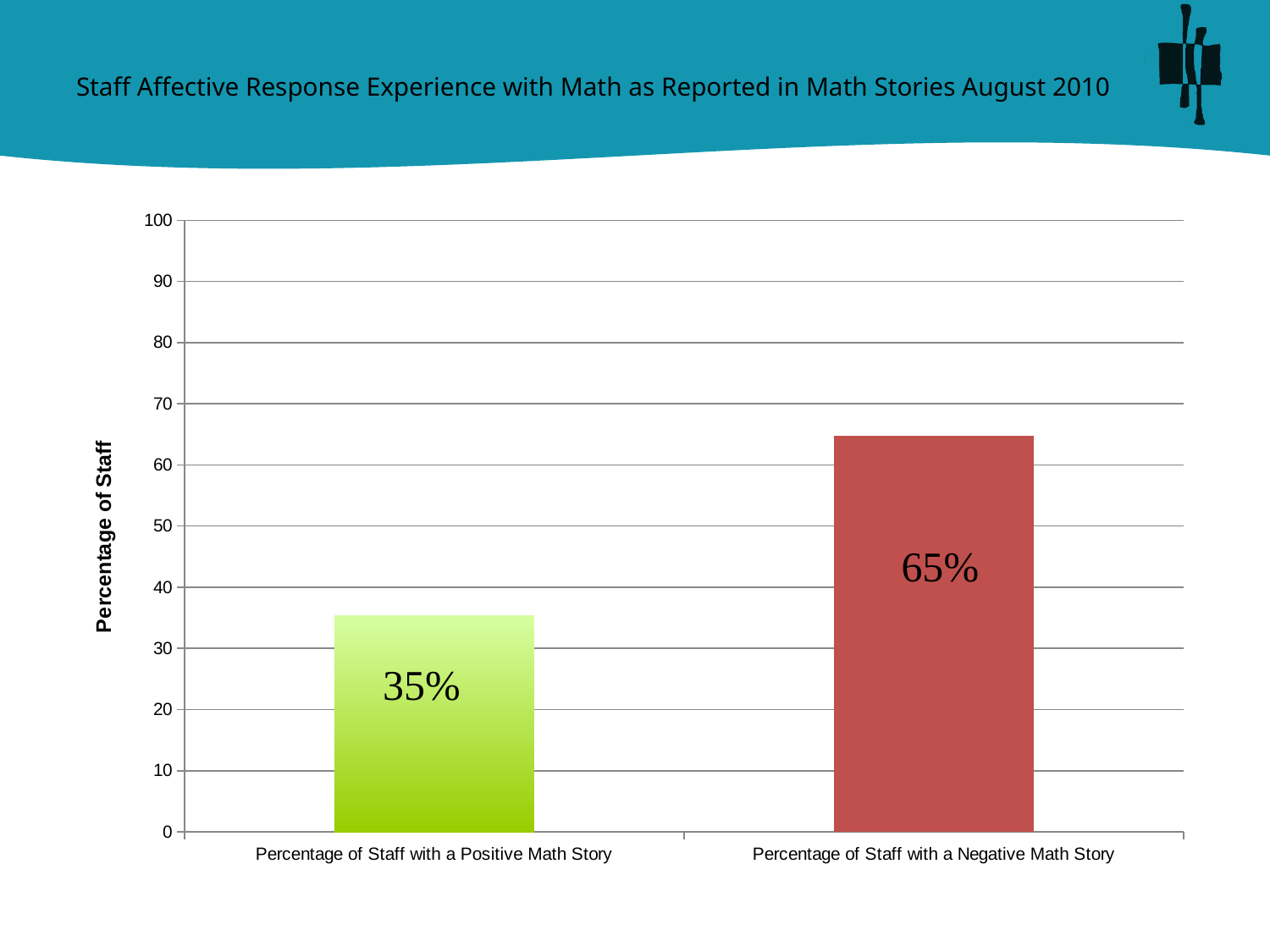
Is the value for staff with a negative math story greater or less than 60? greater What is the total of the two percentages shown on the chart? 100% Is the value for staff with a positive math story greater or less than 40? less What percentage of staff reported a negative math story? 65% What percentage of staff reported a positive math story? 35% Which category has the higher value? Percentage of Staff with a Negative Math Story What kind of chart is shown on the slide? Bar chart How many categories are shown on the chart? 2 What is the label of the vertical axis? Percentage of Staff Which category has the lower value? Percentage of Staff with a Positive Math Story What is the title of the slide? Staff Affective Response Experience with Math as Reported in Math Stories August 2010 What is the difference between the percentage of staff with a negative math story and the percentage with a positive math story? 30%